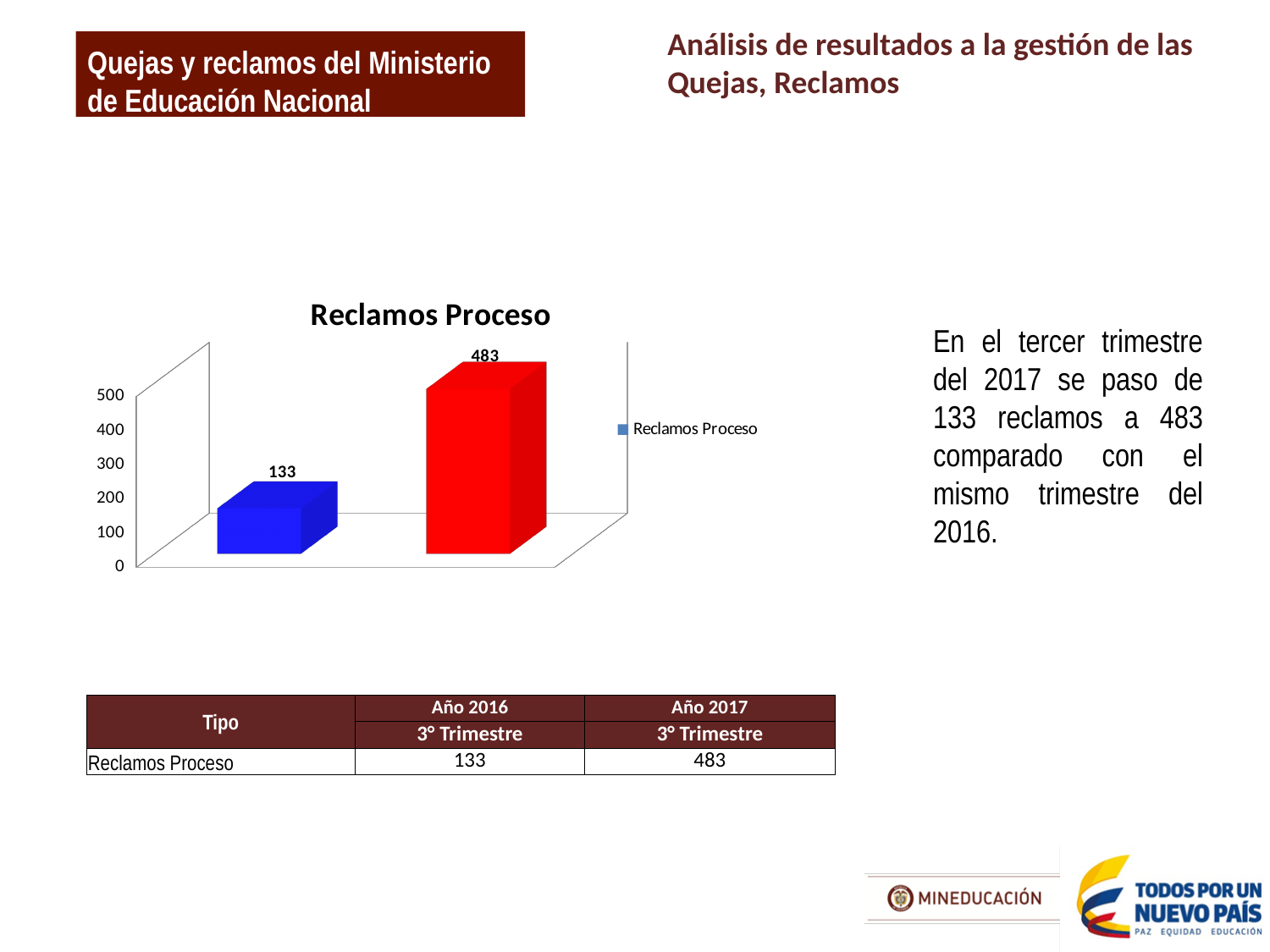
What is the name of the series listed in the chart legend? Reclamos Proceso What is the title of the chart? Reclamos Proceso Do the values in the Reclamos Proceso chart rise or fall from the left bar to the right bar? rise Which bar in the Reclamos Proceso chart has the highest value, the blue one or the red one? the red one Which bar in the Reclamos Proceso chart has the lowest value, the blue one or the red one? the blue one What is the value shown on the left (blue) bar of the Reclamos Proceso chart? 133 What is the difference between the red bar (483) and the blue bar (133) in the Reclamos Proceso chart? 350 What type of chart is shown on the slide? bar chart How many bars are plotted in the Reclamos Proceso chart? 2 What is the value shown on the right (red) bar of the Reclamos Proceso chart? 483 Is the value of the red bar in the Reclamos Proceso chart greater or less than 400? greater How many series does the legend of the chart list? 1